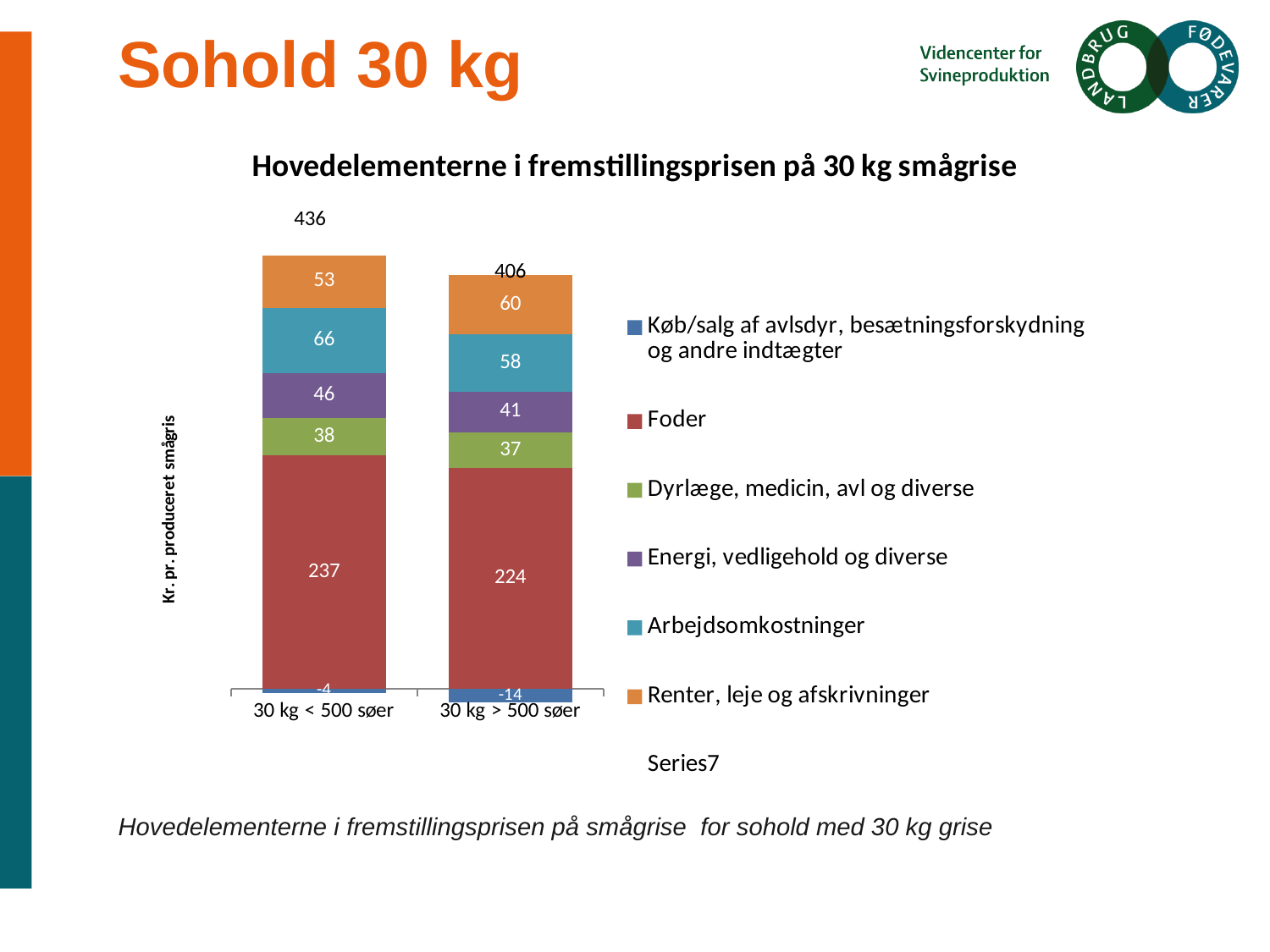
What is the Foder value for '30 kg > 500 søer'? 224 What is the difference in Foder between '30 kg < 500 søer' and '30 kg > 500 søer'? 13 How many entries does the legend list? 7 What type of chart is shown on the slide? Stacked bar chart What is the total shown above the bar for '30 kg < 500 søer'? 436 Which category has the larger Renter, leje og afskrivninger value? 30 kg > 500 søer What is the Arbejdsomkostninger value for '30 kg > 500 søer'? 58 What is the total shown above the bar for '30 kg > 500 søer'? 406 How many categories are shown on the x axis? 2 What is the Foder value for '30 kg < 500 søer'? 237 What is the Køb/salg af avlsdyr, besætningsforskydning og andre indtægter value for '30 kg > 500 søer'? -14 What is the Renter, leje og afskrivninger value for '30 kg < 500 søer'? 53